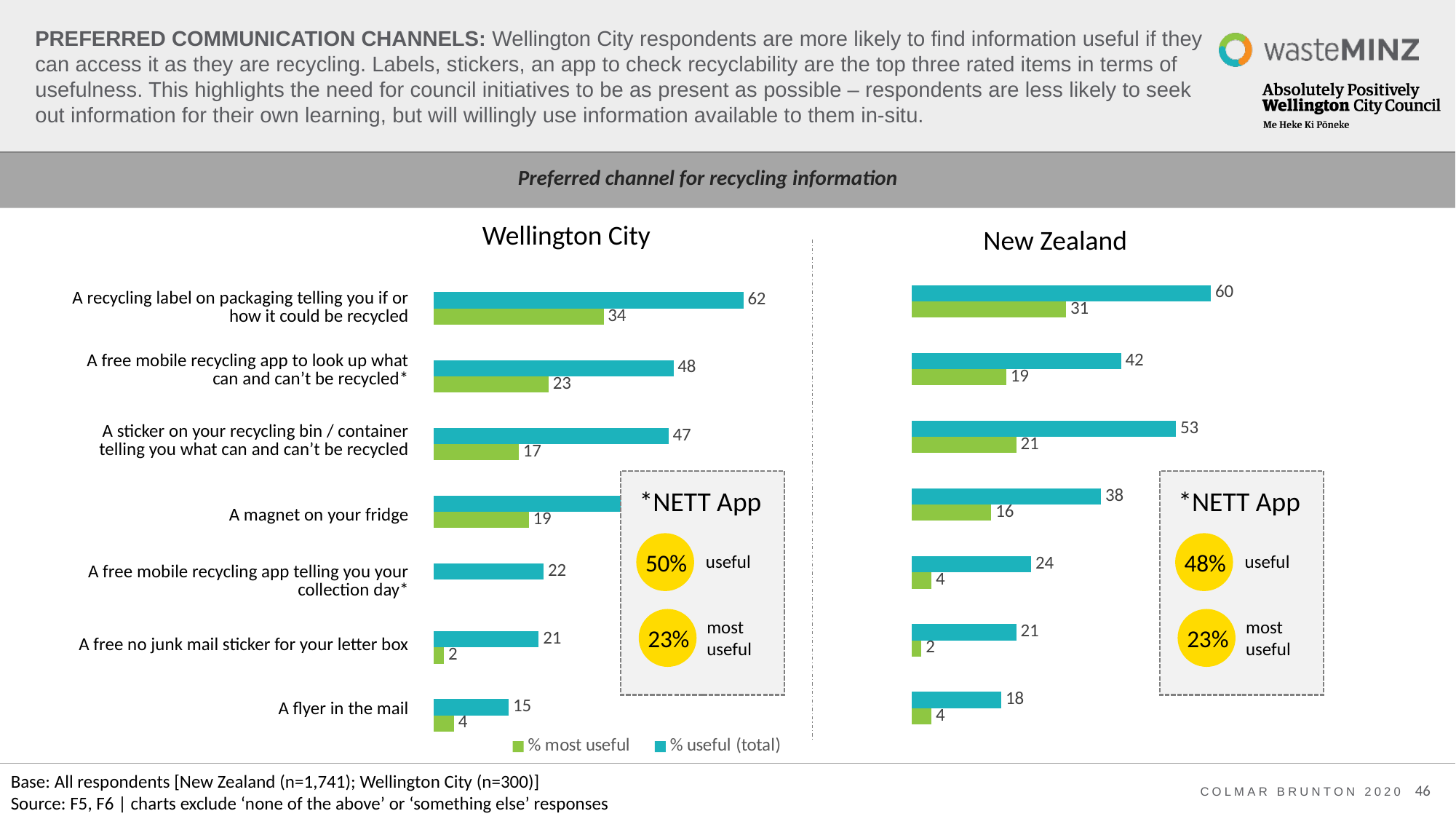
What type of chart is used for the Wellington City data? Bar chart In the New Zealand chart, which channel has the lowest % useful (total) value? A flyer in the mail In the New Zealand chart, what is the % useful (total) value for 'A magnet on your fridge'? 38 What is the NETT App 'useful' percentage shown for Wellington City? 50% In the Wellington City chart, which channel has the highest % useful (total) value? A recycling label on packaging telling you if or how it could be recycled Which is larger: the % useful (total) for 'A sticker on your recycling bin / container' in the Wellington City chart or in the New Zealand chart? New Zealand What colour represents the '% most useful' series in the legend? Green In the Wellington City chart, what is the difference between the % useful (total) and % most useful values for 'A free mobile recycling app to look up what can and can't be recycled'? 25 In the Wellington City chart, what is the % useful (total) value for 'A recycling label on packaging telling you if or how it could be recycled'? 62 How many series does the legend list? 2 How many channels are listed in the Wellington City chart? 7 In the New Zealand chart, what is the % most useful value for 'A sticker on your recycling bin / container telling you what can and can't be recycled'? 21